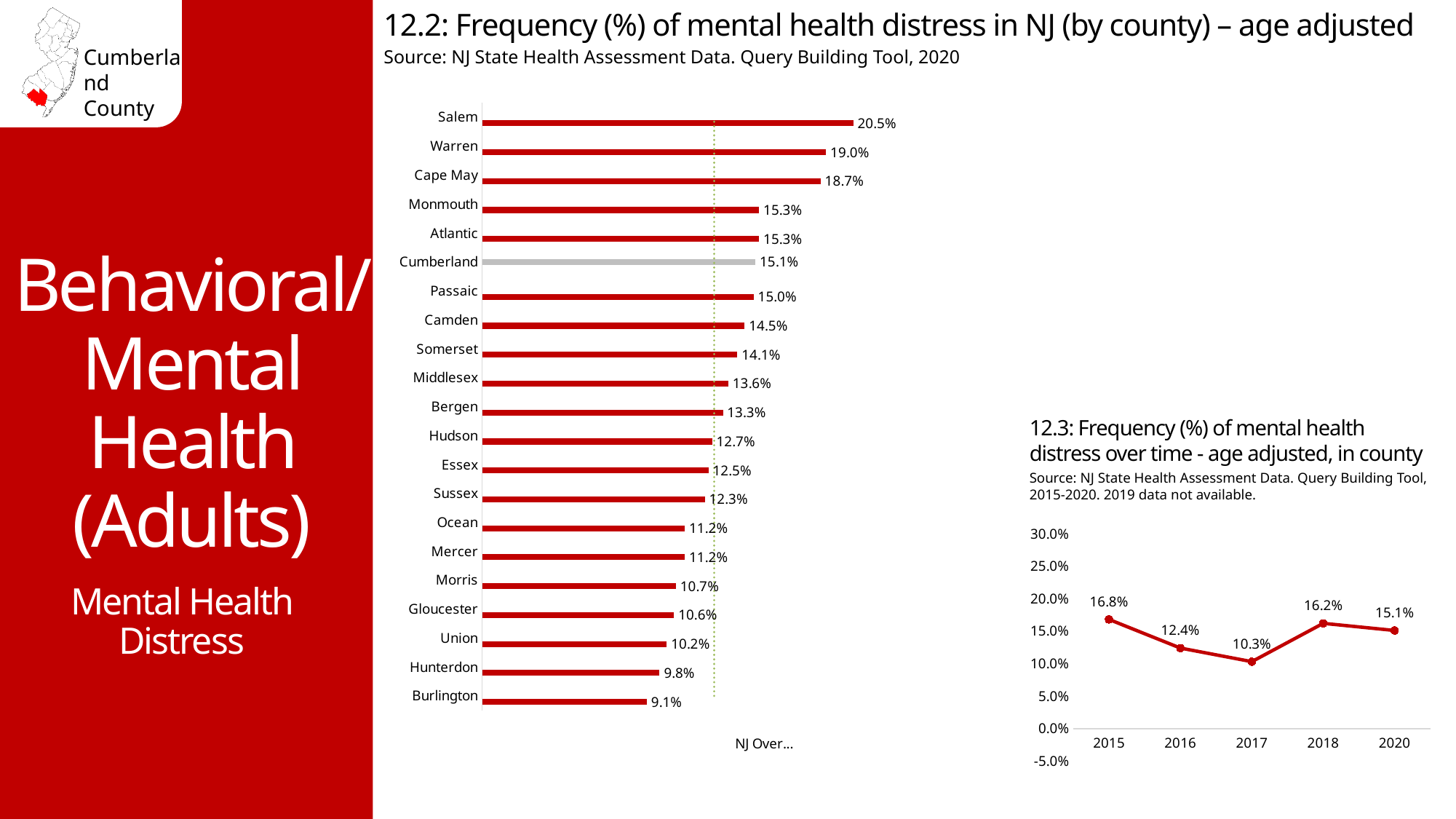
In chart 12.3 (over time), how many data points are plotted? 5 In chart 12.2 (by county), what is the difference between Salem and Burlington? 11.4% In chart 12.2 (by county), which county has the lowest frequency of mental health distress? Burlington What kind of chart is chart 12.3 (over time)? Line chart In chart 12.2 (by county), how many counties are shown? 21 In chart 12.2 (by county), which county has the highest frequency of mental health distress? Salem In chart 12.3 (over time), what is the difference between 2018 and 2017? 5.9% In chart 12.3 (over time), which year has the highest value? 2015 In chart 12.2 (by county), what is the value for Cumberland? 15.1% What kind of chart is chart 12.2 (by county)? Bar chart In chart 12.2 (by county), which is larger, the value for Warren or the value for Cape May? Warren In chart 12.3 (over time), what is the value for 2017? 10.3%